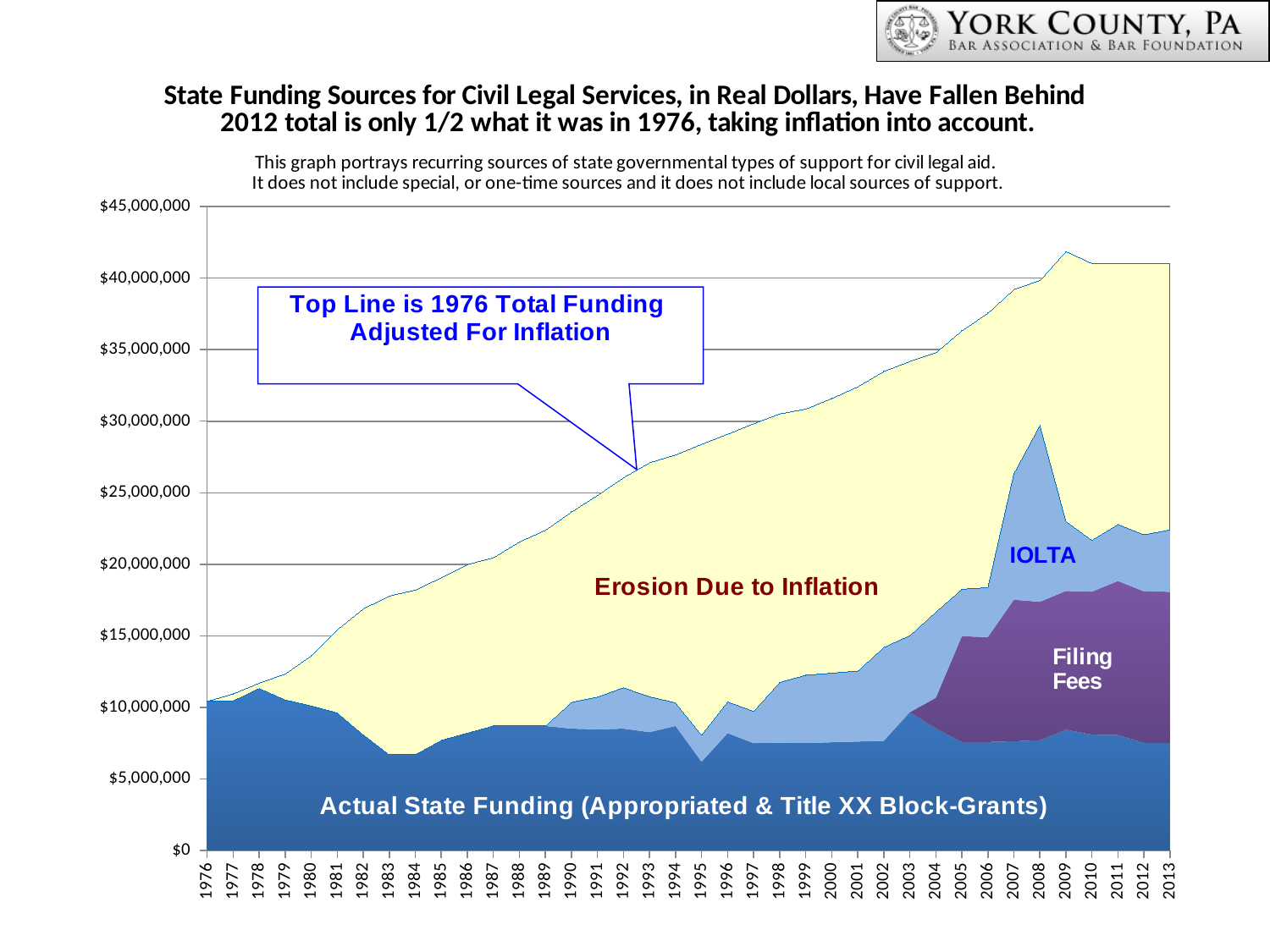
What is the first year shown on the x axis? 1976 What does the label in the large yellow area of the chart say? Erosion Due to Inflation Is the total stacked funding (state funding, filing fees and IOLTA) in 2013 greater or less than $25,000,000? less How many years are shown along the x axis of the chart? 38 Does the top line (1976 total funding adjusted for inflation) rise or fall from 1976 to 2013? rise Is the top line (1976 total funding adjusted for inflation) in 2013 greater or less than $40,000,000? greater Is the Actual State Funding value in 1995 greater or less than $10,000,000? less Which is larger: the top line value in 1976 or in 2013? 2013 What is the last year shown on the x axis? 2013 What kind of chart is shown on the slide? Area chart